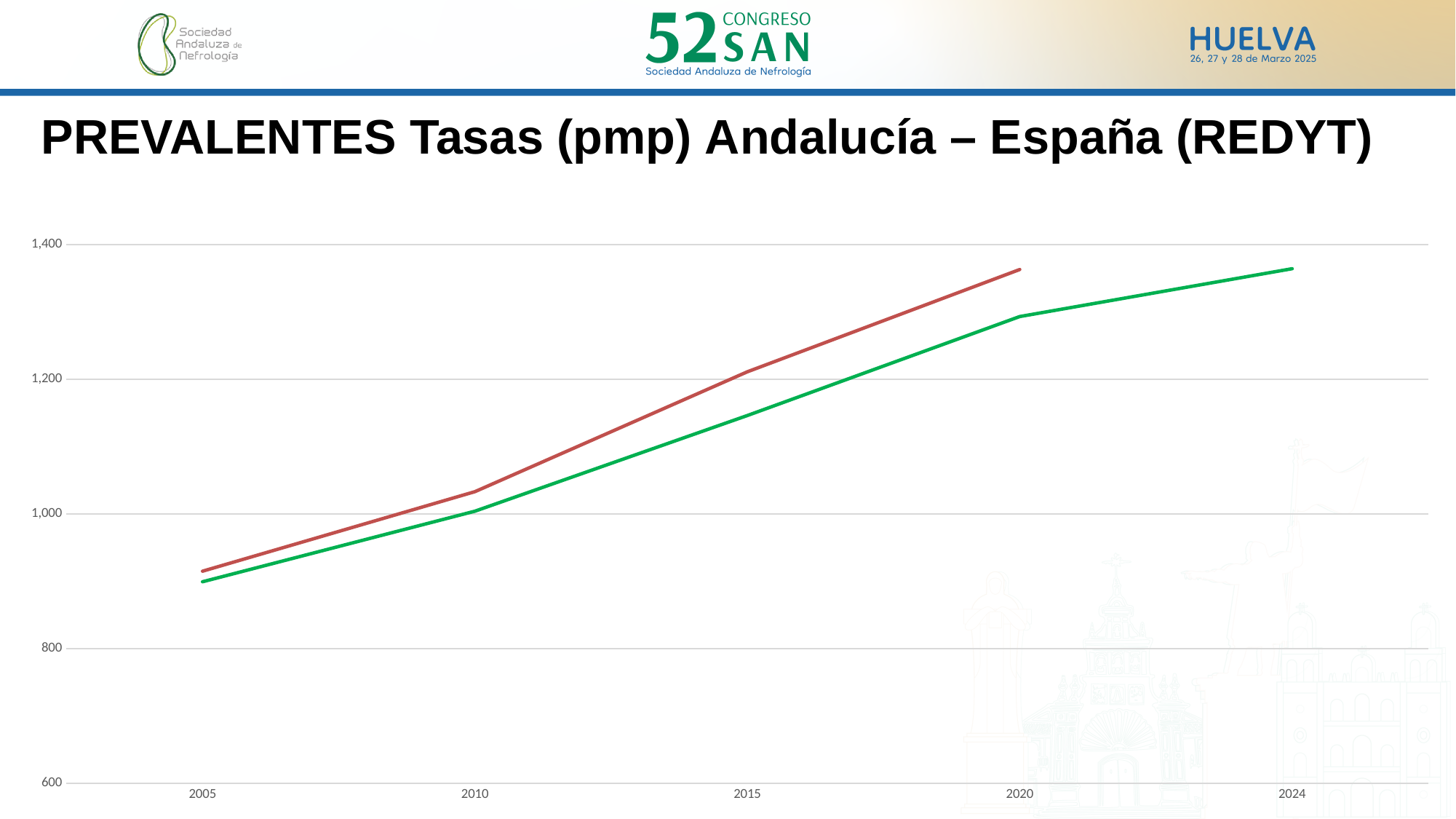
Is the value of the green line in 2024 greater or less than 1,200? greater Is the value of the red line in 2020 greater or less than 1,200? greater In 2015, which line has the higher value, the red line or the green line? red line Is the value of the green line in 2005 greater or less than 1,000? less How many lines are plotted on the chart? 2 Do the values of the red line rise or fall from 2005 to 2020? rise What is the title of the chart on the slide? PREVALENTES Tasas (pmp) Andalucía – España (REDYT) How many year labels are shown on the x axis? 5 Do the values of the green line rise or fall from 2005 to 2024? rise What kind of chart is shown on the slide? line chart What is the last year labelled on the x axis? 2024